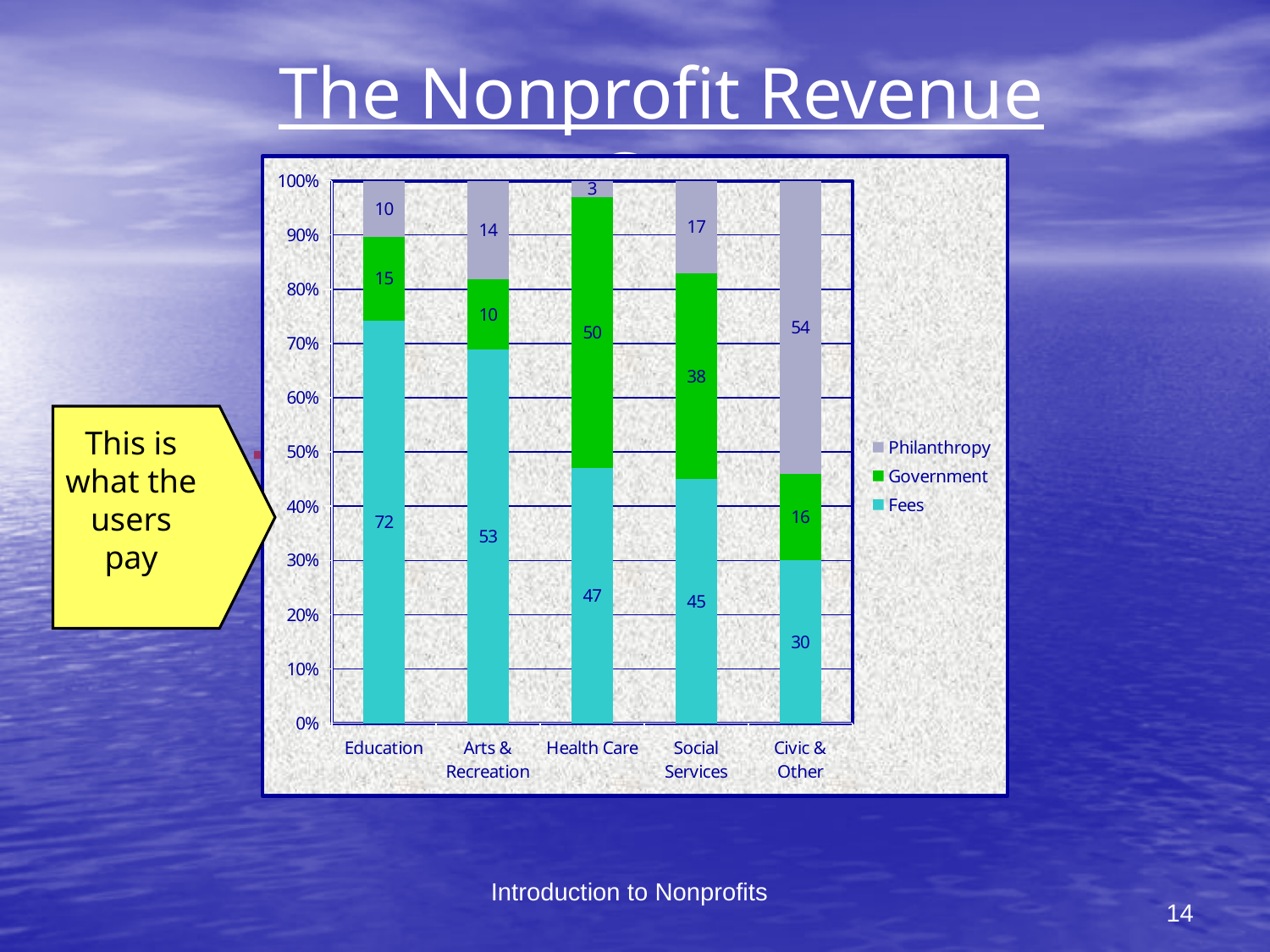
What kind of chart is shown on the slide? Stacked bar chart Which series is shown in green in the legend? Government What is the Philanthropy value for Health Care? 3 What is the Philanthropy value for Civic & Other? 54 Which category has the lowest Philanthropy value? Health Care What is the Government value for Health Care? 50 What is the difference between the Fees values for Education and Civic & Other? 42 How many series does the legend list? 3 Which category has the highest Fees value? Education What is the Fees value for Education? 72 Which is larger, the Government value for Social Services or the Government value for Arts & Recreation? Social Services How many categories are shown on the x axis? 5